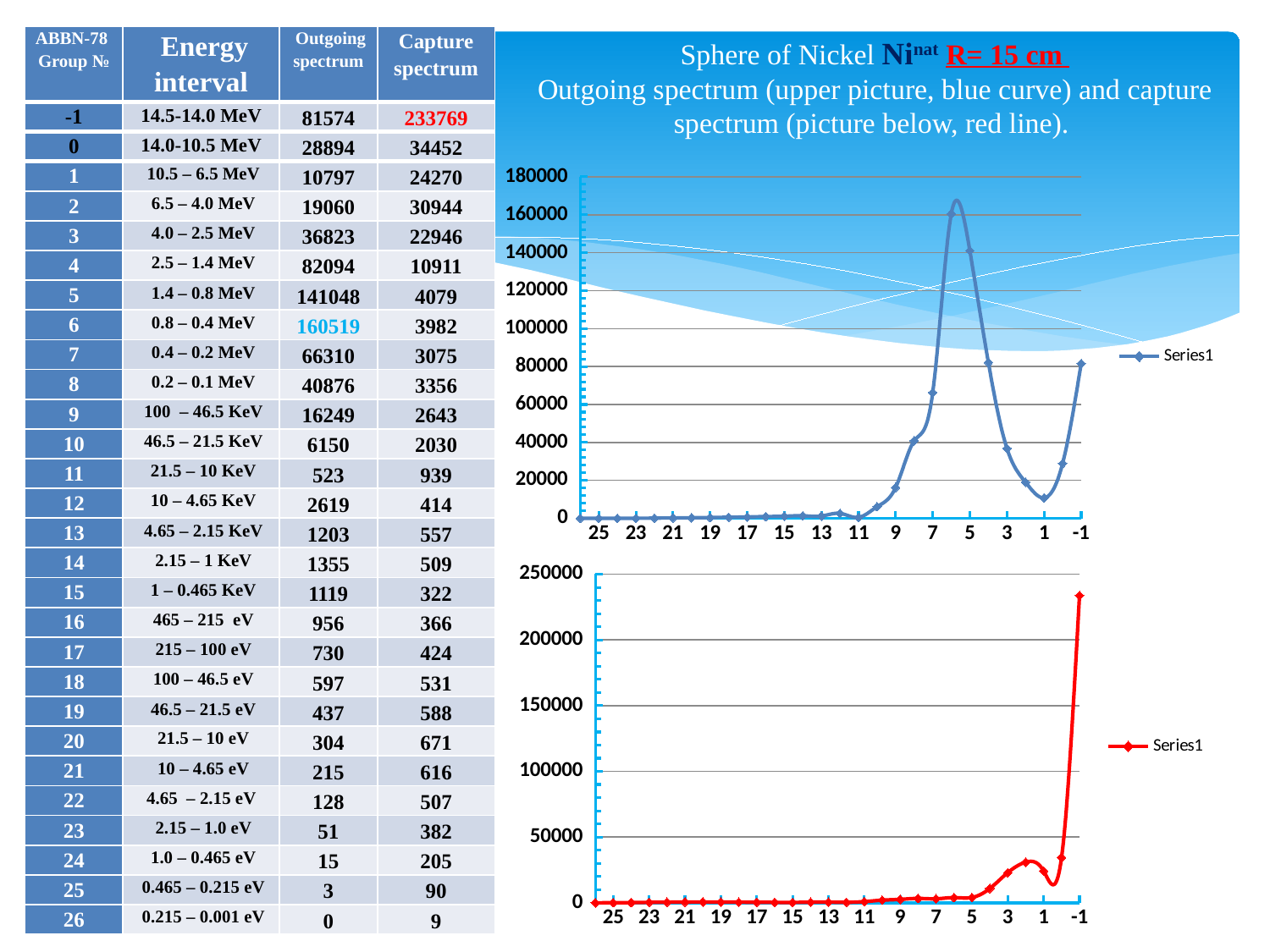
What is the legend entry shown for the upper chart? Series1 In the lower chart, is the value at group -1 greater or less than 200000? greater In the lower chart, do the values generally rise or fall moving from group 25 to group -1 along the x axis? rise In the lower chart, at which x-axis group does the curve reach its highest value? -1 In the upper chart, is the value at group -1 greater or less than 100000? less In the upper chart, which is larger: the value at group 9 or the value at group 3? group 3 In the lower chart, is the value at group 3 greater or less than 50000? less What colour is the line in the lower chart? red What kind of chart is the upper chart on the slide? line chart In the upper chart, at which x-axis group does the curve reach its highest value? 6 How many series does the legend of the lower chart list? 1